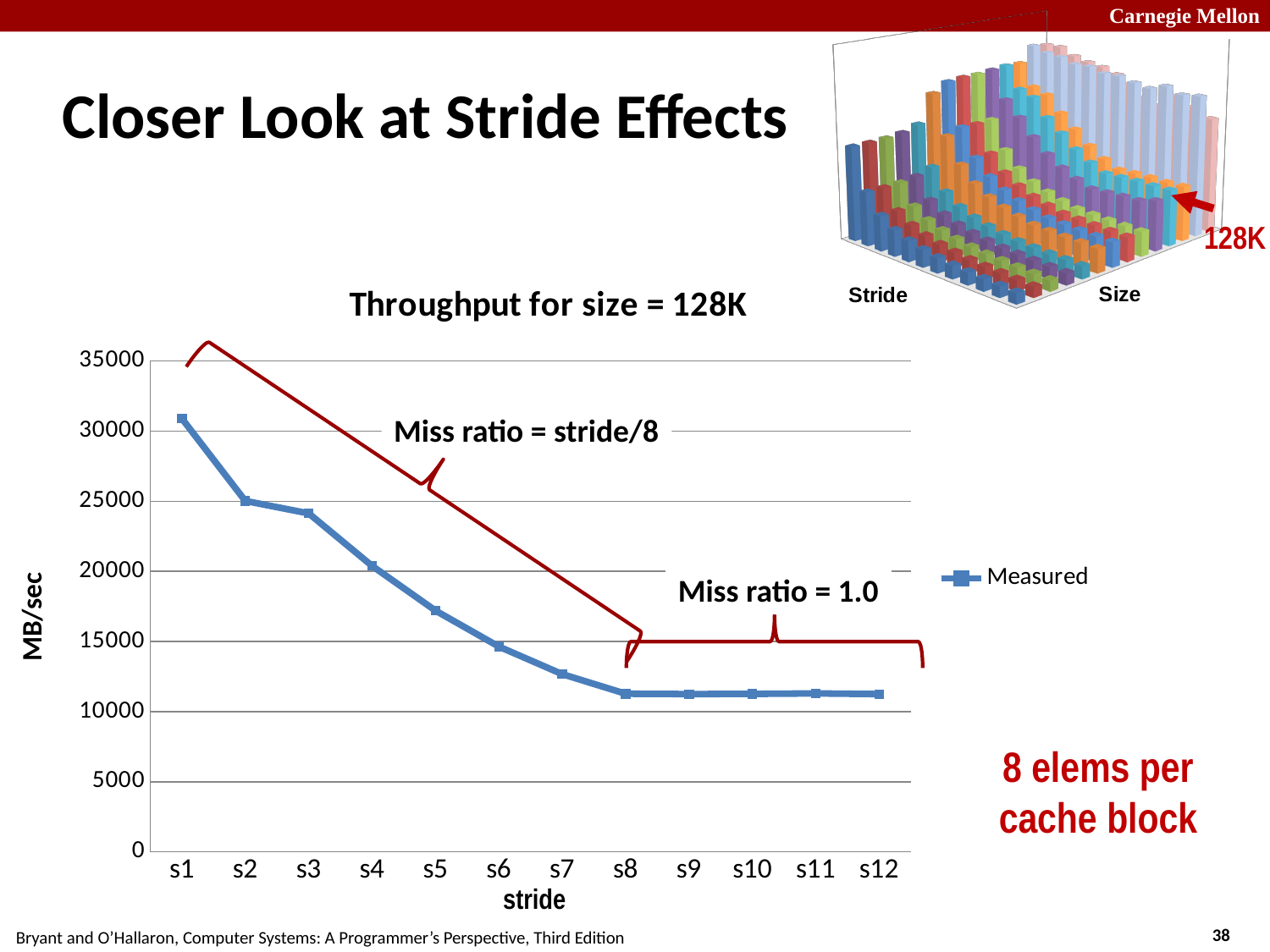
In the 'Throughput for size = 128K' chart, which has the larger measured throughput, s3 or s6? s3 In the 'Throughput for size = 128K' chart, is the measured value for s1 greater or less than 30000? greater In the 'Throughput for size = 128K' chart, which stride has the highest measured throughput? s1 In the 'Throughput for size = 128K' chart, is the measured value for s10 greater or less than 10000? greater In the 'Throughput for size = 128K' chart, is the measured value for s5 greater or less than 15000? greater What is the label of the y axis on the 'Throughput for size = 128K' chart? MB/sec In the 'Throughput for size = 128K' chart, does the measured throughput rise or fall as stride increases from s1 to s8? fall How many series does the legend of the 'Throughput for size = 128K' chart list? 1 What kind of chart is the 'Throughput for size = 128K' chart? line chart What is the name of the series shown in the legend of the 'Throughput for size = 128K' chart? Measured In the 'Throughput for size = 128K' chart, how many stride categories are shown on the x axis? 12